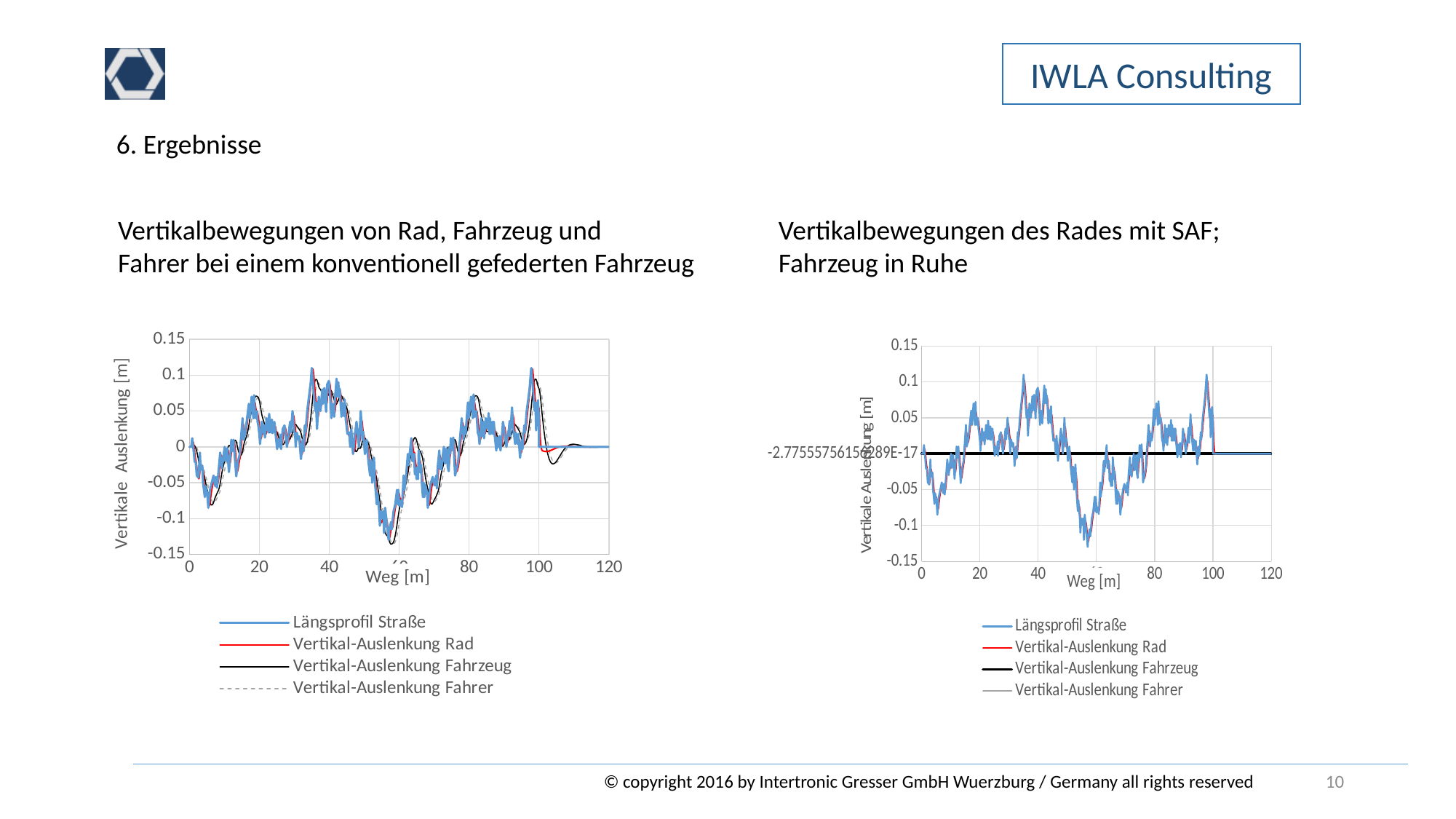
In the left chart, is the value of Längsprofil Straße at about 57 m greater or less than -0.1? less What is the highest tick value shown on the x axis of the right chart? 120 How many series does the legend of the left chart list? 4 In the right chart, is the value of Längsprofil Straße at about 20 m greater or less than 0? greater How many series does the legend of the right chart list? 4 In the left chart, is the value of Längsprofil Straße at about 5 m greater or less than 0? less In the left chart, which series is drawn as a dashed line according to the legend? Vertikal-Auslenkung Fahrer In the left chart, what is the label of the x axis? Weg [m] What kind of chart is the left chart (Vertikalbewegungen von Rad, Fahrzeug und Fahrer bei einem konventionell gefederten Fahrzeug)? line chart What kind of chart is the right chart (Vertikalbewegungen des Rades mit SAF; Fahrzeug in Ruhe)? line chart